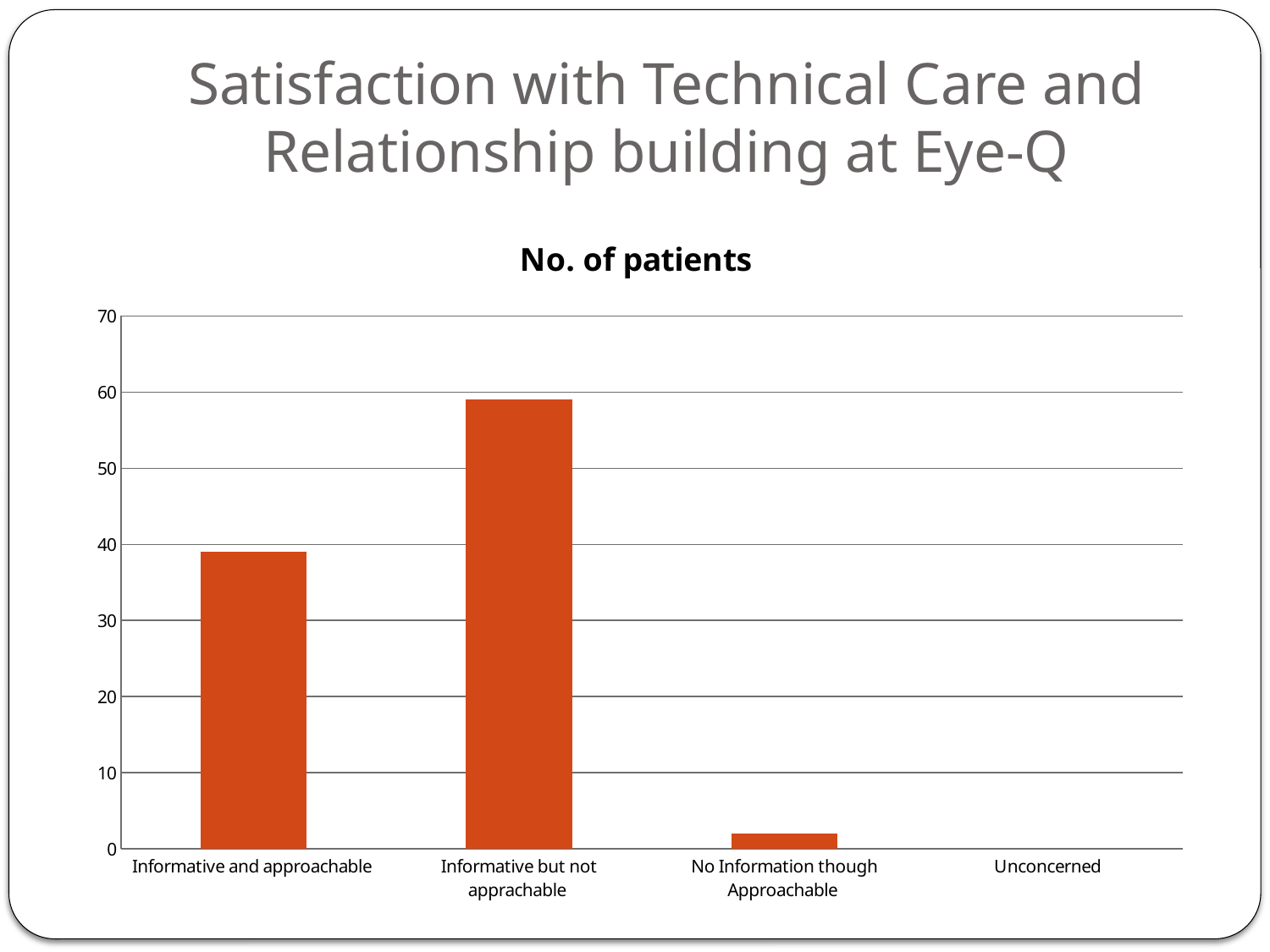
Is the value for 'No Information though Approachable' greater or less than 10? less Which category has the lowest number of patients? Unconcerned Is the value for 'Informative but not apprachable' greater or less than 50? greater What type of chart is shown on the slide? bar chart What is the value for 'Unconcerned'? 0 Which is larger: the value for 'Informative and approachable' or the value for 'Informative but not apprachable'? Informative but not apprachable What colour are the bars in the chart? orange What is the title of the chart? No. of patients Which category has the highest number of patients? Informative but not apprachable Is the value for 'Informative and approachable' greater or less than 50? less How many categories are shown on the x axis of the chart? 4